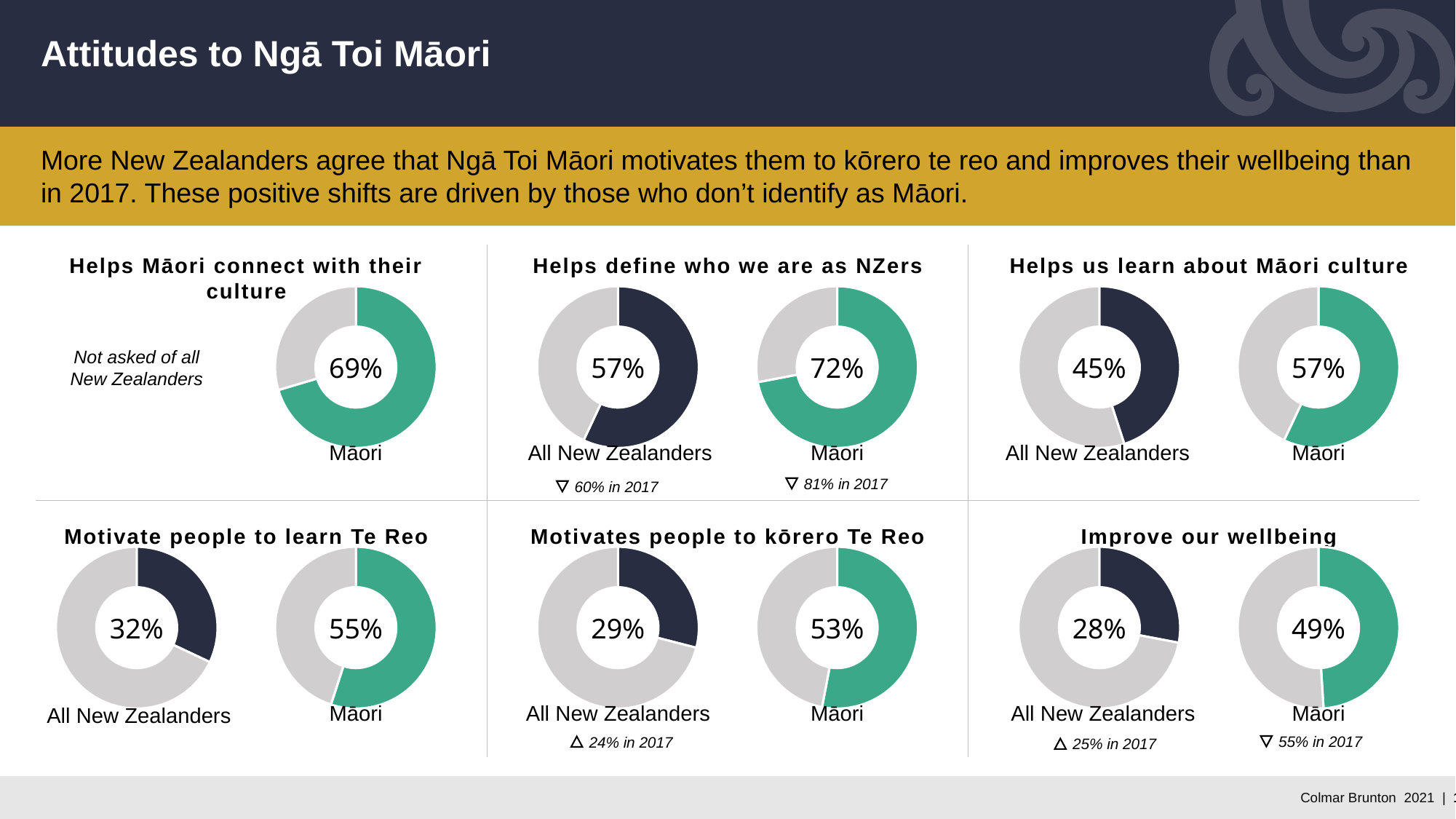
How many donut charts are shown on the slide in total? 11 In the 'Improve our wellbeing' chart, what was the All New Zealanders value in 2017? 25% In the 'Improve our wellbeing' chart, what percentage is shown for Māori? 49% In the 'Motivates people to kōrero Te Reo' chart, what is the difference between the Māori value and the All New Zealanders value? 24 percentage points In the 'Helps define who we are as NZers' chart, what percentage is shown for All New Zealanders? 57% In the 'Helps Māori connect with their culture' chart, what percentage is shown for Māori? 69% In the 'Helps us learn about Māori culture' chart, what percentage is shown for All New Zealanders? 45% In the 'Helps define who we are as NZers' chart, what percentage is shown for Māori? 72% Across all the charts on the slide, which chart shows the highest value for Māori? Helps define who we are as NZers What type of chart is used to display the percentages on this slide? Donut chart In the 'Motivate people to learn Te Reo' chart, which group has the higher value, All New Zealanders or Māori? Māori Across all the charts on the slide, which chart shows the lowest value for All New Zealanders? Improve our wellbeing